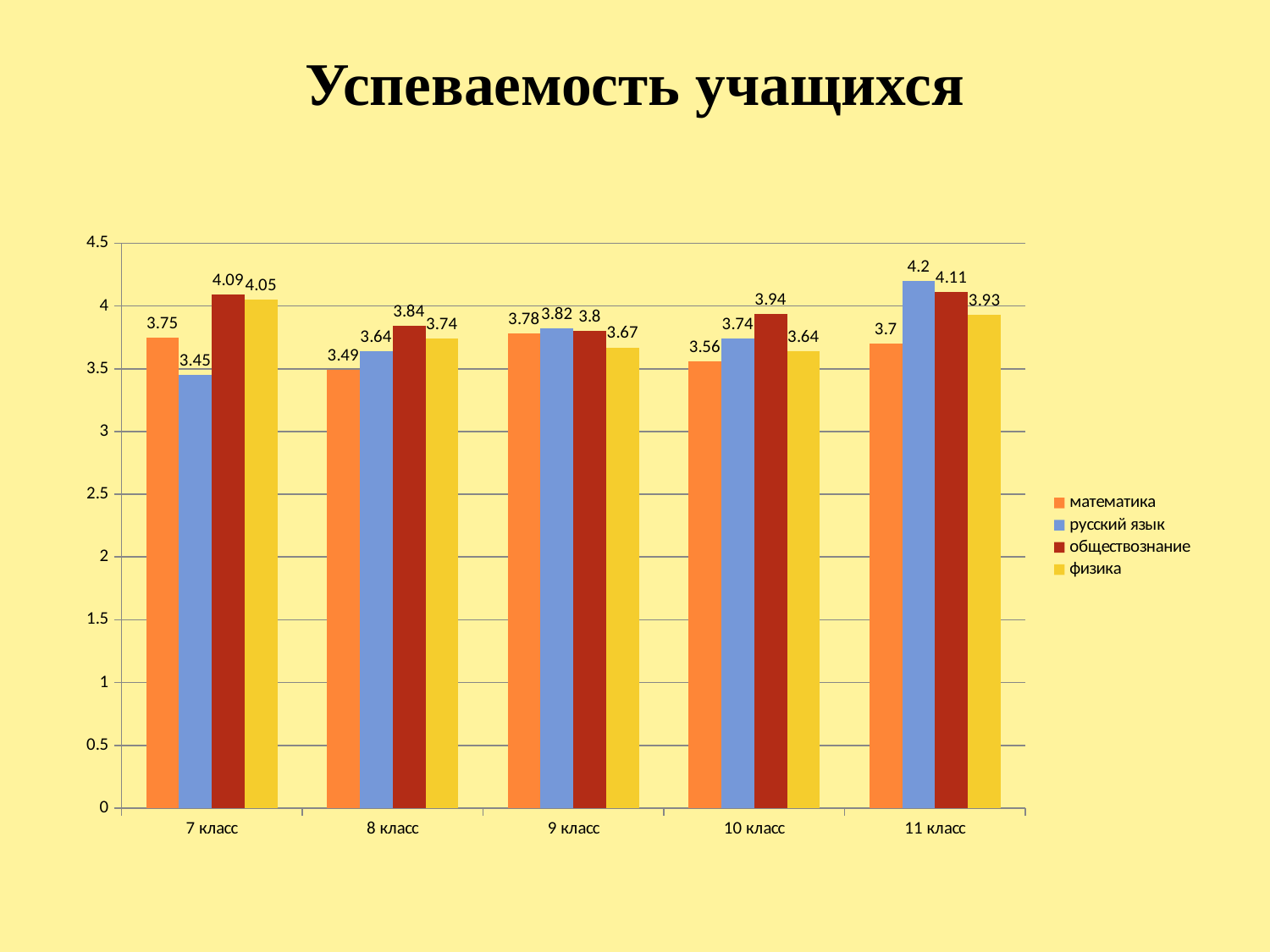
Which is larger in 10 класс: математика or обществознание? обществознание What is the title of the chart? Успеваемость учащихся What is the difference between обществознание and русский язык in 7 класс? 0.64 What is the value for русский язык in 11 класс? 4.2 Is the value for физика in 7 класс greater or less than 4? greater How many classes are shown on the x axis? 5 Which class has the highest value for обществознание? 11 класс What is the value for физика in 9 класс? 3.67 What kind of chart is shown on the slide? bar chart Which class has the lowest value for математика? 8 класс How many series does the legend list? 4 What is the value for математика in 7 класс? 3.75